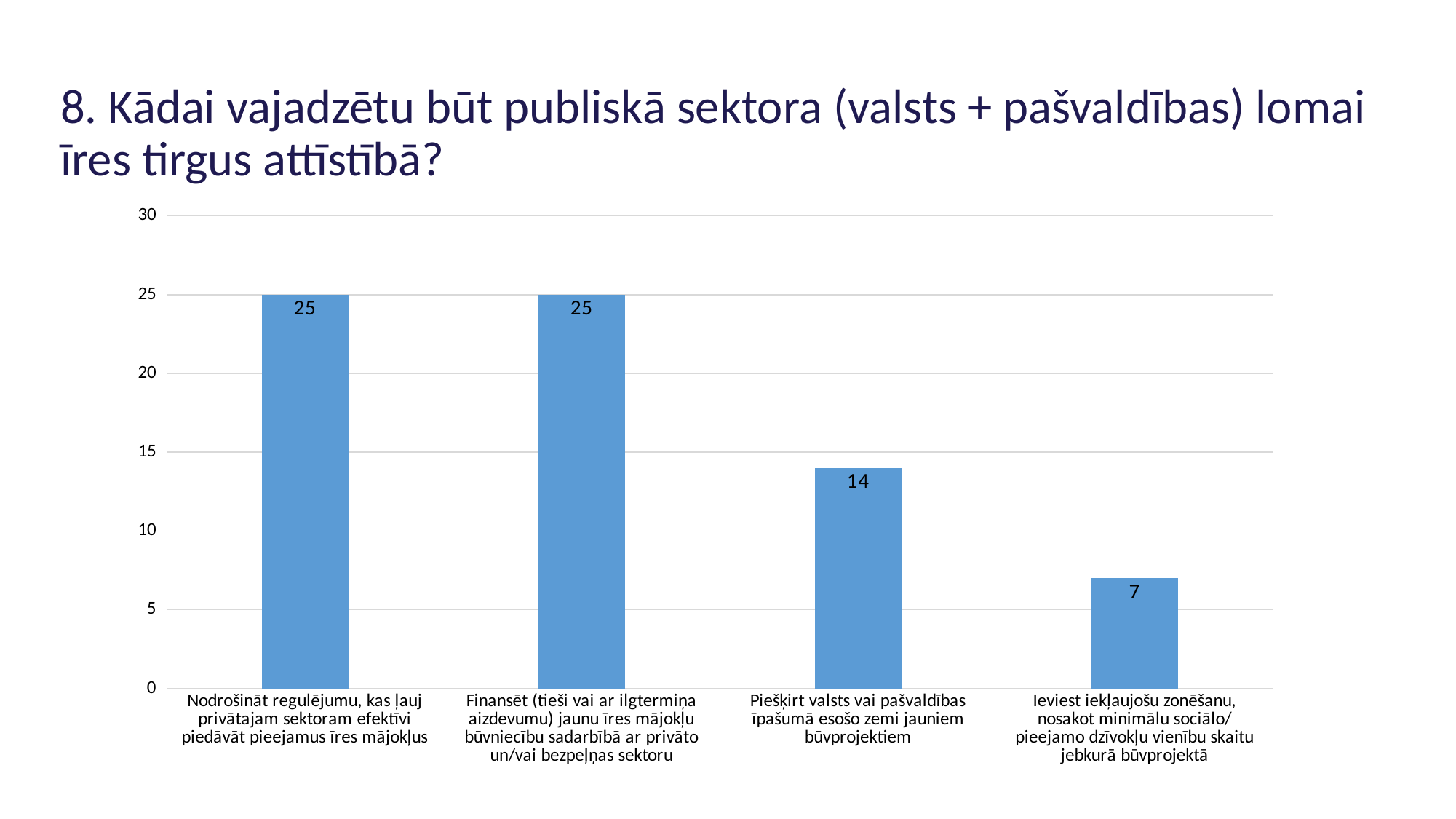
What kind of chart is shown on the slide? bar chart What is the difference between the value for "Nodrošināt regulējumu..." and the value for "Piešķirt valsts vai pašvaldības īpašumā esošo zemi jauniem būvprojektiem"? 11 What is the difference between the value for "Piešķirt valsts vai pašvaldības īpašumā esošo zemi jauniem būvprojektiem" and the value for "Ieviest iekļaujošu zonēšanu..."? 7 What value is shown for "Ieviest iekļaujošu zonēšanu, nosakot minimālu sociālo/pieejamo dzīvokļu vienību skaitu jebkurā būvprojektā"? 7 Which category has the lowest value? Ieviest iekļaujošu zonēšanu, nosakot minimālu sociālo/pieejamo dzīvokļu vienību skaitu jebkurā būvprojektā What value is shown for "Finansēt (tieši vai ar ilgtermiņa aizdevumu) jaunu īres mājokļu būvniecību sadarbībā ar privāto un/vai bezpeļņas sektoru"? 25 What is the highest value shown on the vertical axis? 30 Which is larger: the value for "Finansēt (tieši vai ar ilgtermiņa aizdevumu)..." or the value for "Piešķirt valsts vai pašvaldības īpašumā esošo zemi jauniem būvprojektiem"? Finansēt (tieši vai ar ilgtermiņa aizdevumu) jaunu īres mājokļu būvniecību sadarbībā ar privāto un/vai bezpeļņas sektoru What value is shown for "Nodrošināt regulējumu, kas ļauj privātajam sektoram efektīvi piedāvāt pieejamus īres mājokļus"? 25 How many categories are shown on the chart? 4 What value is shown for "Piešķirt valsts vai pašvaldības īpašumā esošo zemi jauniem būvprojektiem"? 14 Is the value for "Ieviest iekļaujošu zonēšanu..." greater or less than 10? less